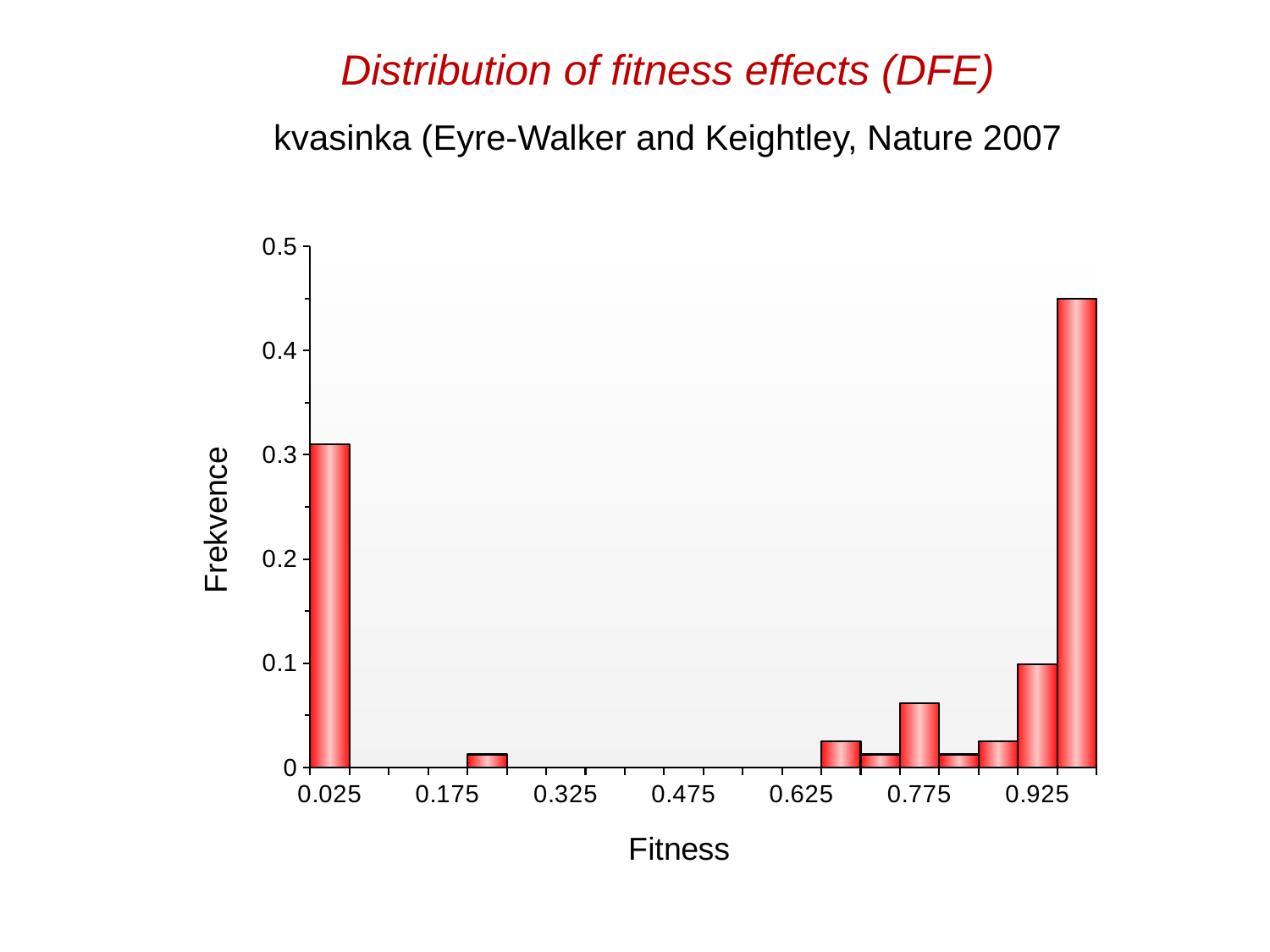
Which is larger: the bar at fitness 0.025 or the rightmost bar? the rightmost bar Is the value for the bar at fitness 0.025 greater or less than 0.4? less Is the tallest bar at the left end or the right end of the x axis? right end Is the value for the rightmost bar greater or less than 0.4? greater Is the value for the bar at fitness 0.025 greater or less than 0.3? greater How many bars are plotted in the chart? 9 What kind of chart is shown on the slide? bar chart Which is larger: the bar at fitness 0.025 or the bar at fitness 0.775? 0.025 What is the title of the x axis? Fitness What is the title of the y axis? Frekvence